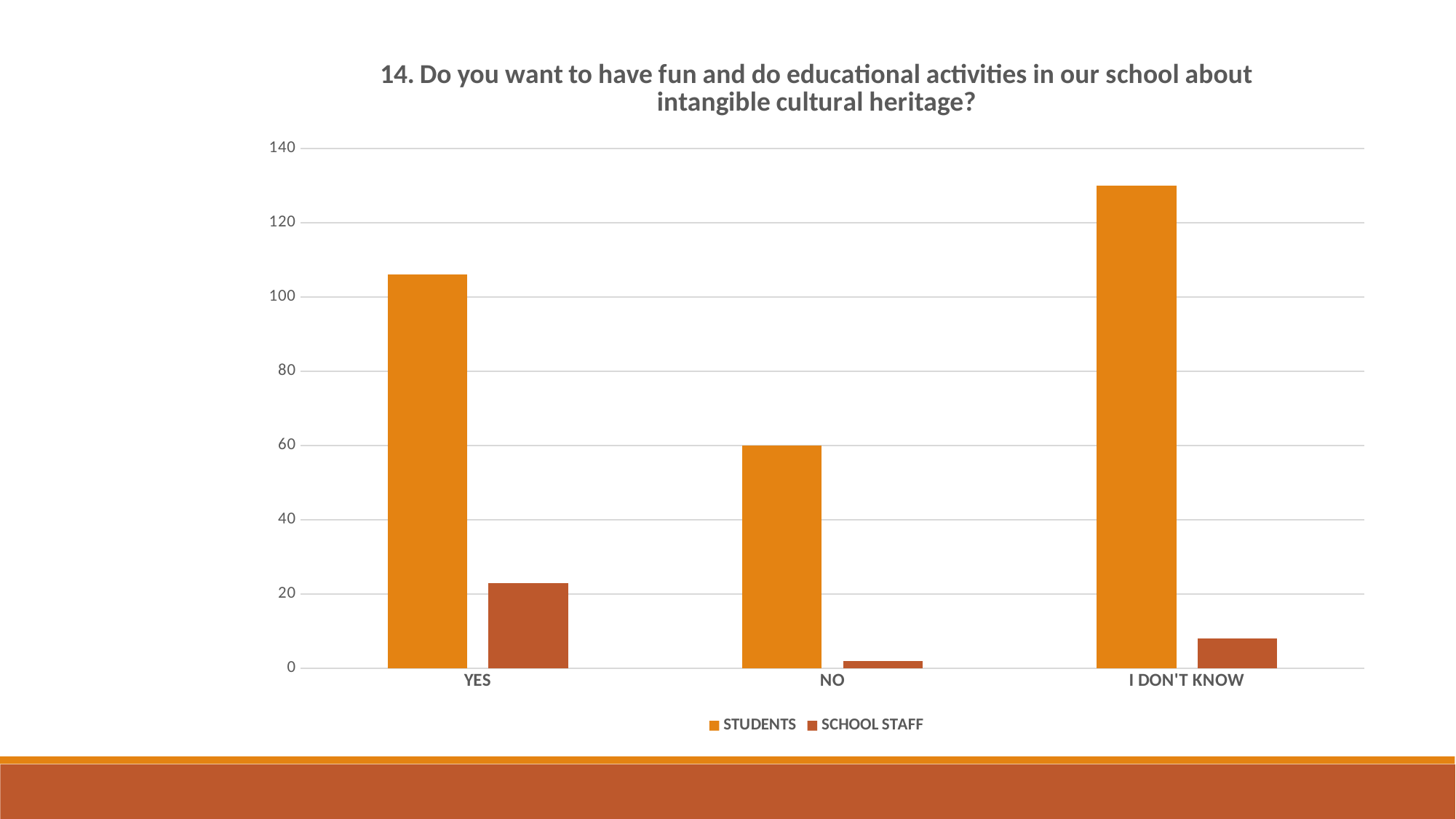
Is the STUDENTS value for YES greater or less than 100? greater Which category has the highest value for SCHOOL STAFF? YES Which series is shown in the darker brown colour in the legend? SCHOOL STAFF How many categories are shown on the x axis? 3 Is the STUDENTS value for I DON'T KNOW greater or less than 120? greater Which category has the highest value for STUDENTS? I DON'T KNOW How many series does the legend list? 2 Is the SCHOOL STAFF value for YES greater or less than 20? greater Which category has the lowest value for SCHOOL STAFF? NO Which category has the lowest value for STUDENTS? NO What kind of chart is shown on the slide? bar chart